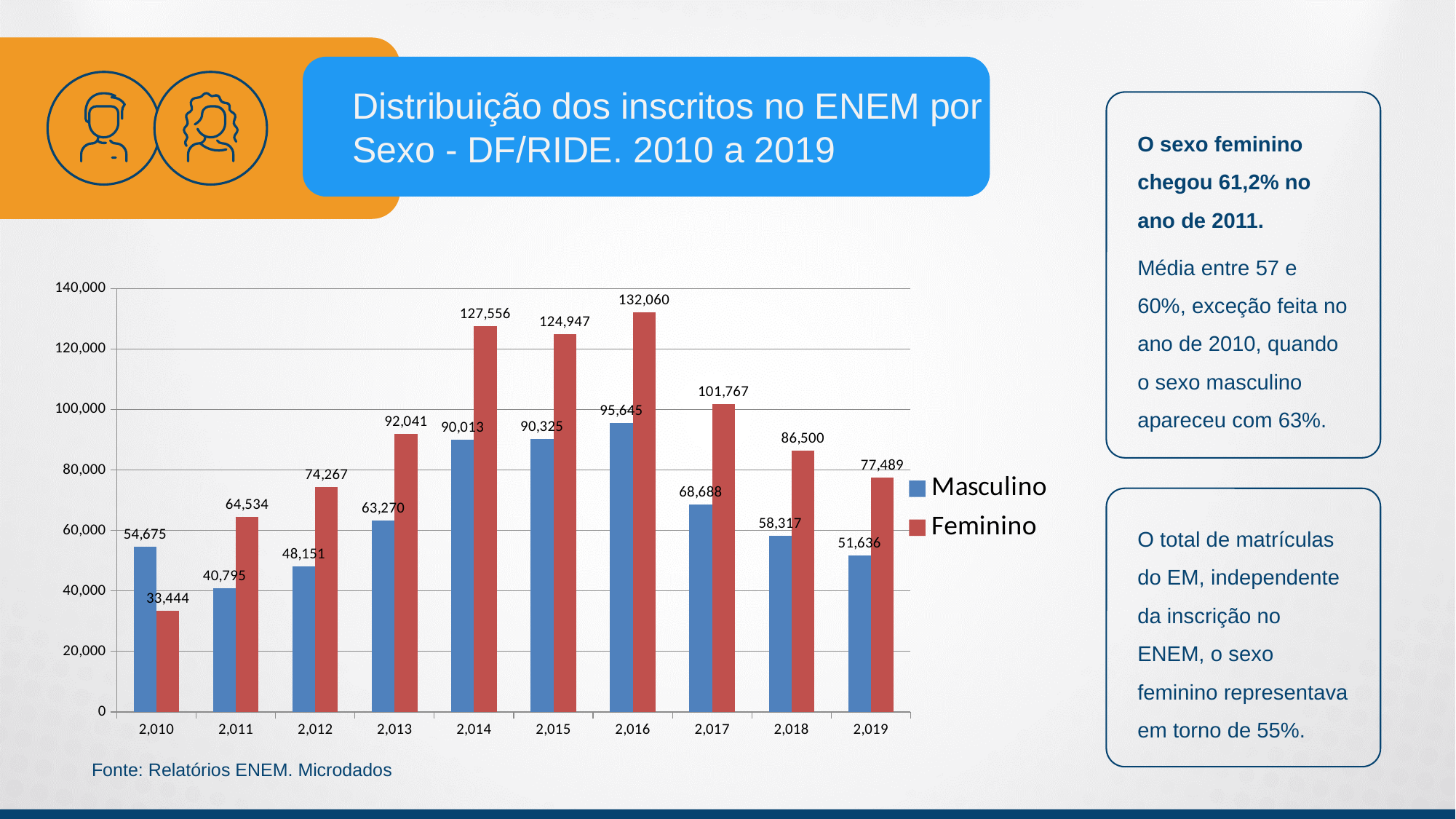
What is the difference between the Feminino and Masculino values in 2019? 25,853 What is the difference between the Feminino and Masculino values in 2016? 36,415 What is the value for Feminino in 2016? 132,060 What kind of chart is shown on the slide? bar chart How many years are shown on the x axis? 10 In which year is the Feminino value highest? 2016 How many series does the legend list? 2 What is the value for Masculino in 2010? 54,675 Is the Feminino value for 2014 greater or less than 120,000? greater In which year is the Masculino value lowest? 2011 Do the Feminino values rise or fall from 2016 to 2019? fall In 2010, which is larger: Masculino or Feminino? Masculino